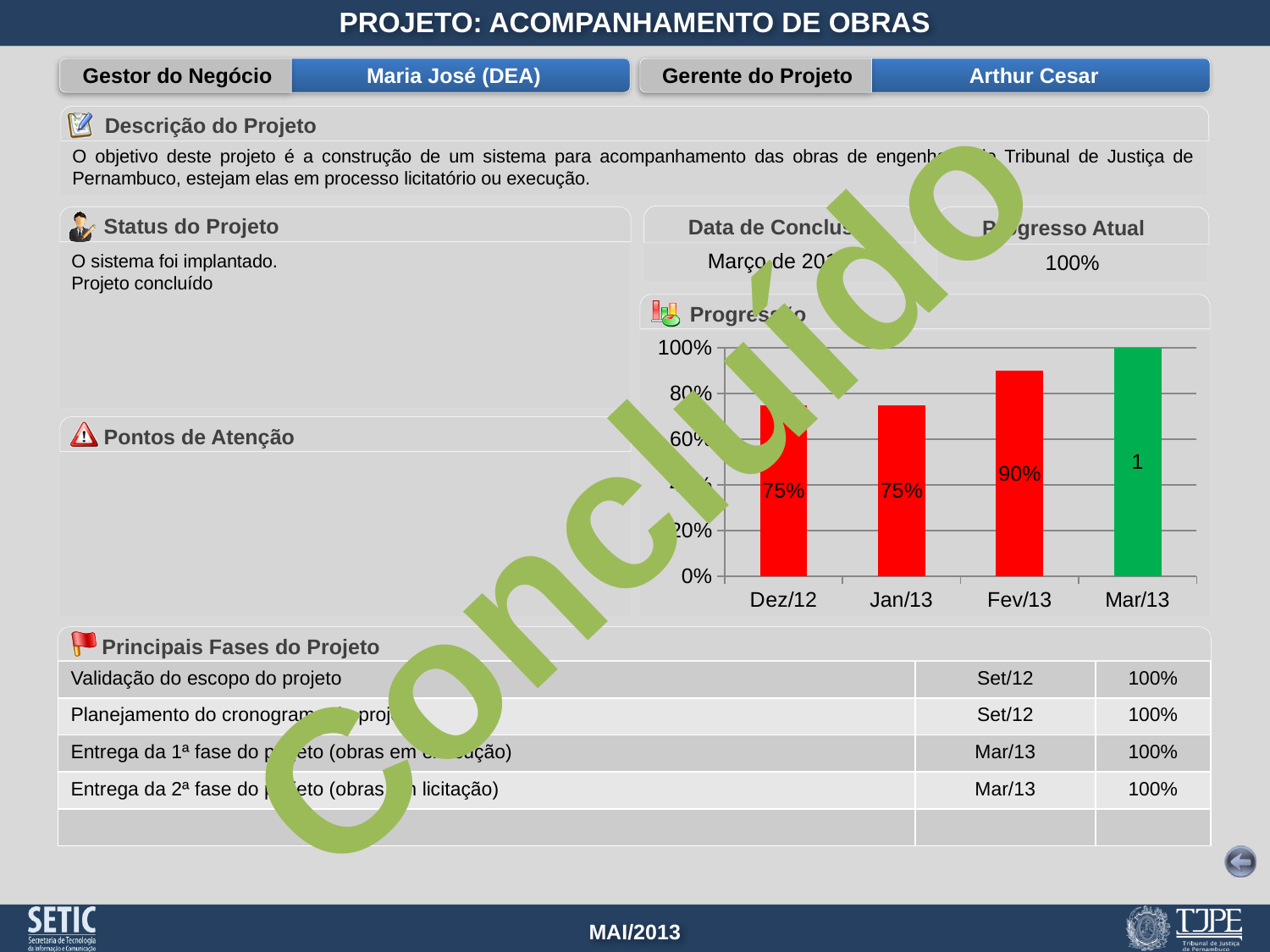
How many months are plotted on the chart? 4 Which month has the highest bar? Mar/13 What is the difference between the value for Fev/13 and the value for Dez/12? 15% Is the value for Mar/13 greater or less than 80%? greater What kind of chart is shown on the slide? bar chart Do the values rise or fall from Dez/12 to Mar/13? rise What is the value shown for Jan/13? 75% Which is larger, the value for Fev/13 or the value for Jan/13? Fev/13 What is the value shown for Dez/12? 75% What data label is printed on the Mar/13 bar? 1 What colour is the Mar/13 bar? green What is the value shown for Fev/13? 90%